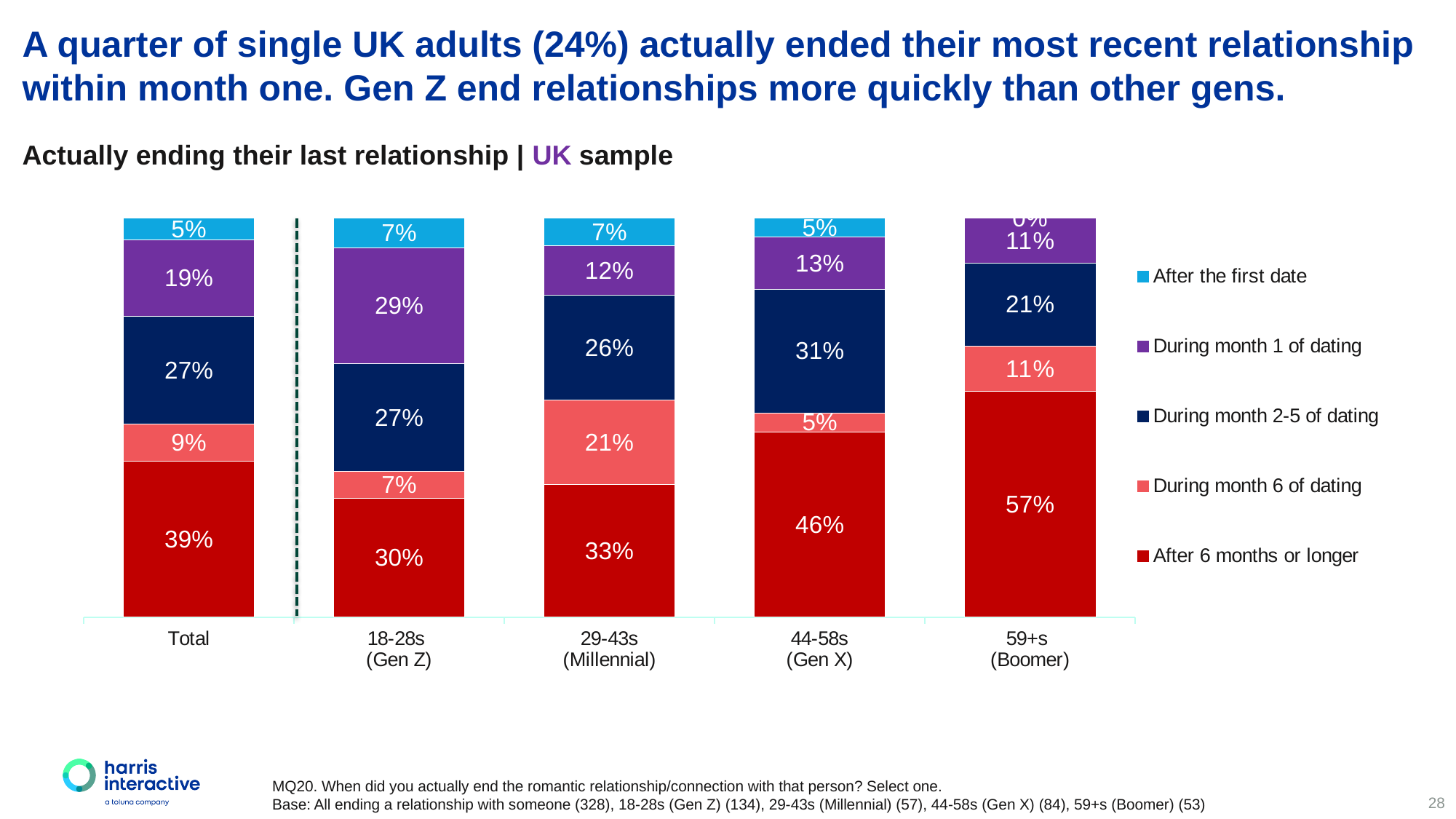
What percentage of 29-43s (Millennial) ended their last relationship during month 6 of dating? 21% What percentage of 18-28s (Gen Z) ended their last relationship during month 1 of dating? 29% Which is larger: the 'During month 1 of dating' share for 18-28s (Gen Z) or for 29-43s (Millennial)? 18-28s (Gen Z) Which age group has the lowest share ending their last relationship after 6 months or longer? 18-28s (Gen Z) What is the difference between the 'After 6 months or longer' share for 59+s (Boomer) and for 18-28s (Gen Z)? 27 percentage points How many age-group categories (including Total) are shown on the x axis? 5 Which age group has the highest share ending their last relationship after 6 months or longer? 59+s (Boomer) What kind of chart is shown on the slide? Stacked bar chart What percentage of 44-58s (Gen X) ended their last relationship during month 2-5 of dating? 31% How many series does the legend list? 5 What percentage of the Total sample ended their last relationship after 6 months or longer? 39% Which legend entry is shown in dark navy blue? During month 2-5 of dating